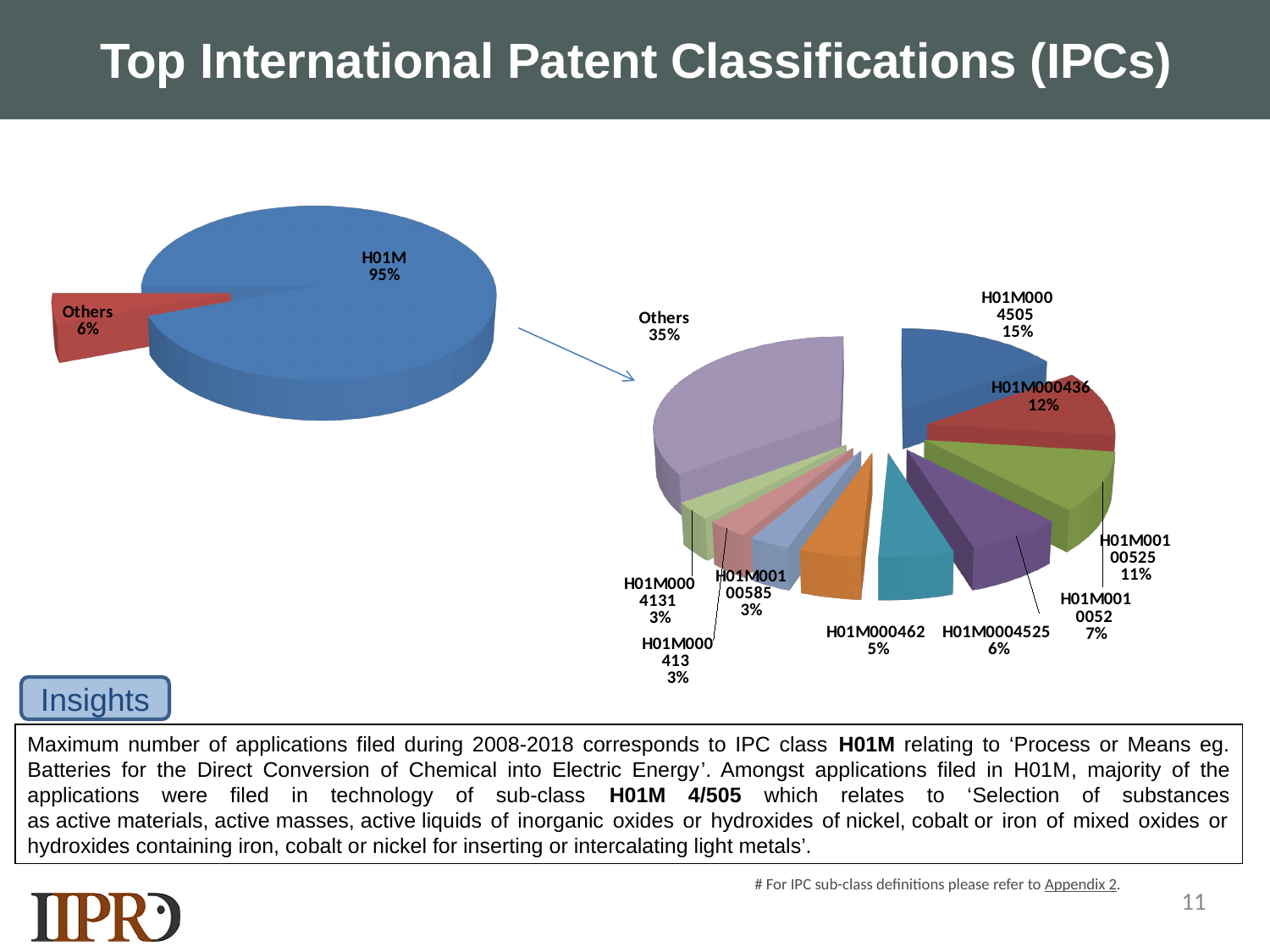
In the left pie chart, what share is labelled for H01M? 95% In the right pie chart, which has the larger share, H01M0004525 or H01M000462? H01M0004525 In the right pie chart, what share is labelled for H01M001 0052? 7% How many slices does the right pie chart have? 10 In the right pie chart, what share is labelled for H01M000 4505? 15% In the right pie chart, excluding Others, which sub-class has the largest share? H01M000 4505 What type of chart is shown on the left of the slide? Pie chart In the left pie chart, what share is labelled for Others? 6% In the right pie chart, what share is labelled for H01M000436? 12% In the right pie chart, what is the difference in share between H01M000 4505 and H01M000436? 3% In the right pie chart, which labelled slice has the largest share? Others In the right pie chart, what share is labelled for H01M000462? 5%